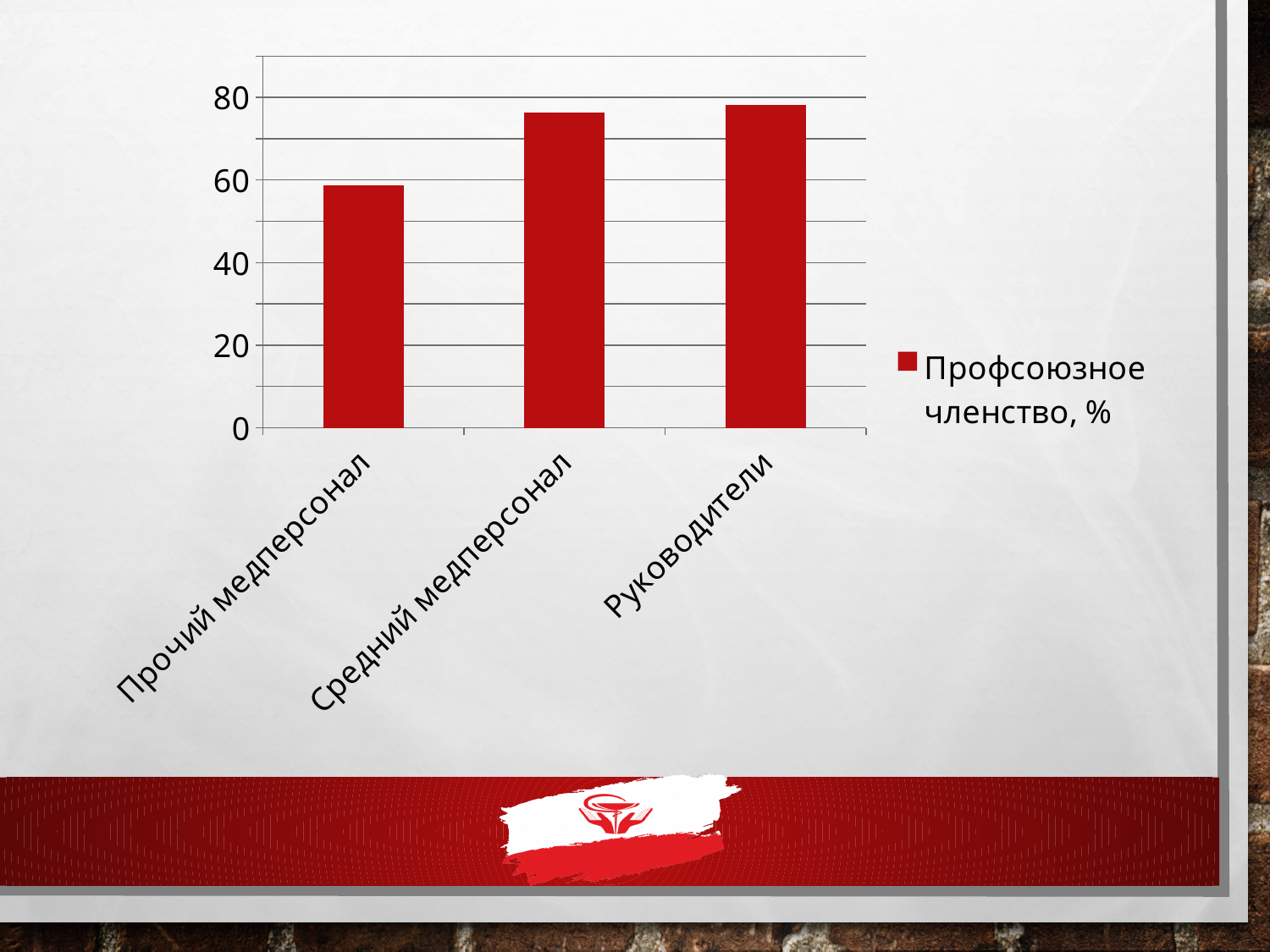
How many series does the chart's legend list? 1 How many categories are shown on the x axis of the chart? 3 Which category has the lowest value in the chart? Прочий медперсонал Do the values rise or fall from left to right along the x axis? rise Is the value for Прочий медперсонал greater or less than 40? greater What is the legend entry for the series in the chart? Профсоюзное членство, % Which is larger, the value for Прочий медперсонал or the value for Средний медперсонал? Средний медперсонал Which is larger, the value for Прочий медперсонал or the value for Руководители? Руководители Is the value for Средний медперсонал greater or less than 60? greater What colour are the bars in the chart? red What kind of chart is shown on the slide? bar chart